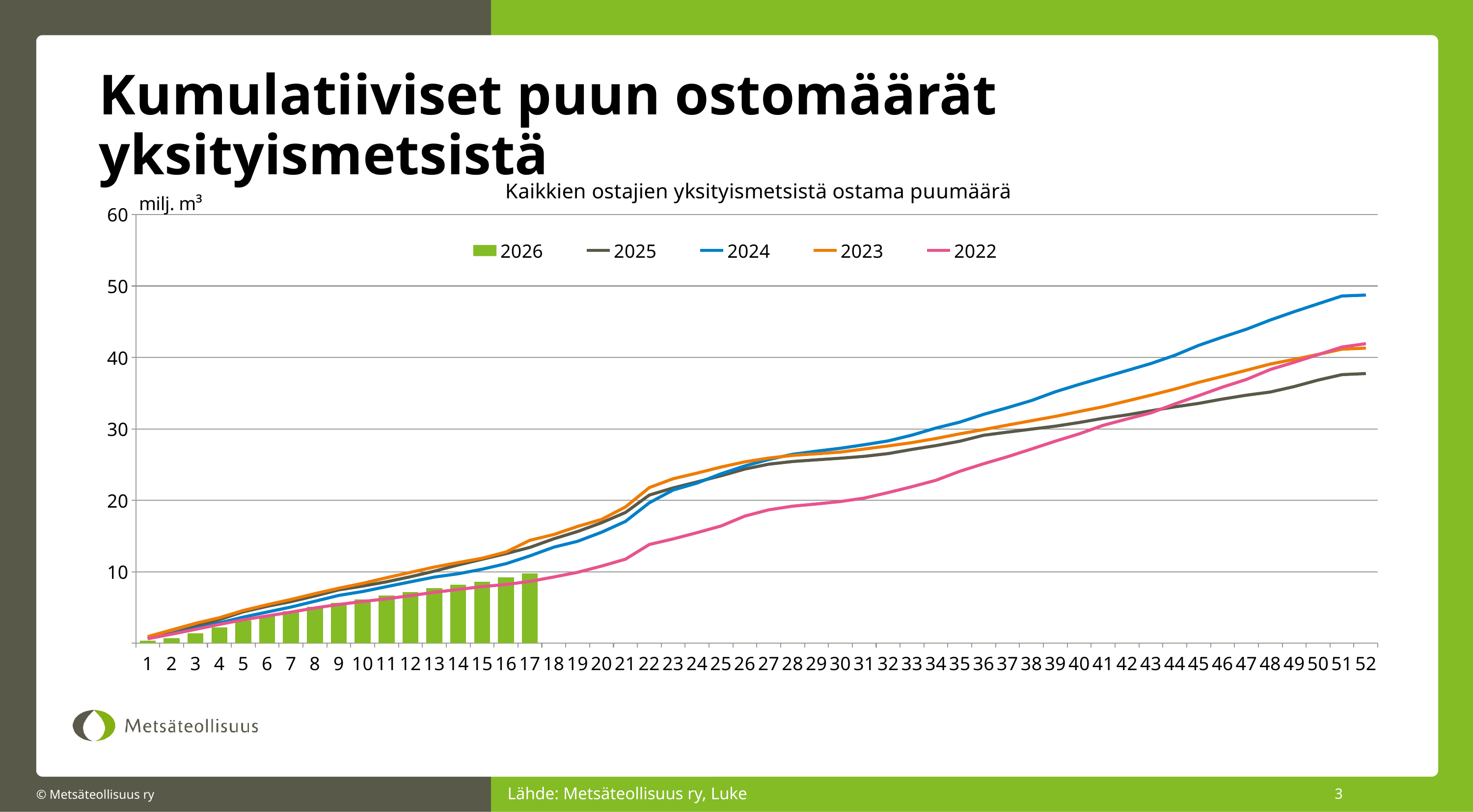
Which series has the highest value at week 52? 2024 At week 30, which is larger: the value for 2023 or the value for 2022? 2023 What kind of chart is this? A combination of a bar chart (2026) and line chart (2022–2025) Is the value for 2024 at week 52 greater or less than 40? greater Is the value for 2022 at week 26 greater or less than 20? less How many weeks are shown on the x axis? 52 Do the values for each series rise or fall along the x axis? rise Up to which week are bars shown for 2026? 17 Which series has the lowest value at week 52? 2025 What unit is shown on the y axis? milj. m³ Is the value for 2025 at week 52 greater or less than 40? less How many series does the legend list? 5